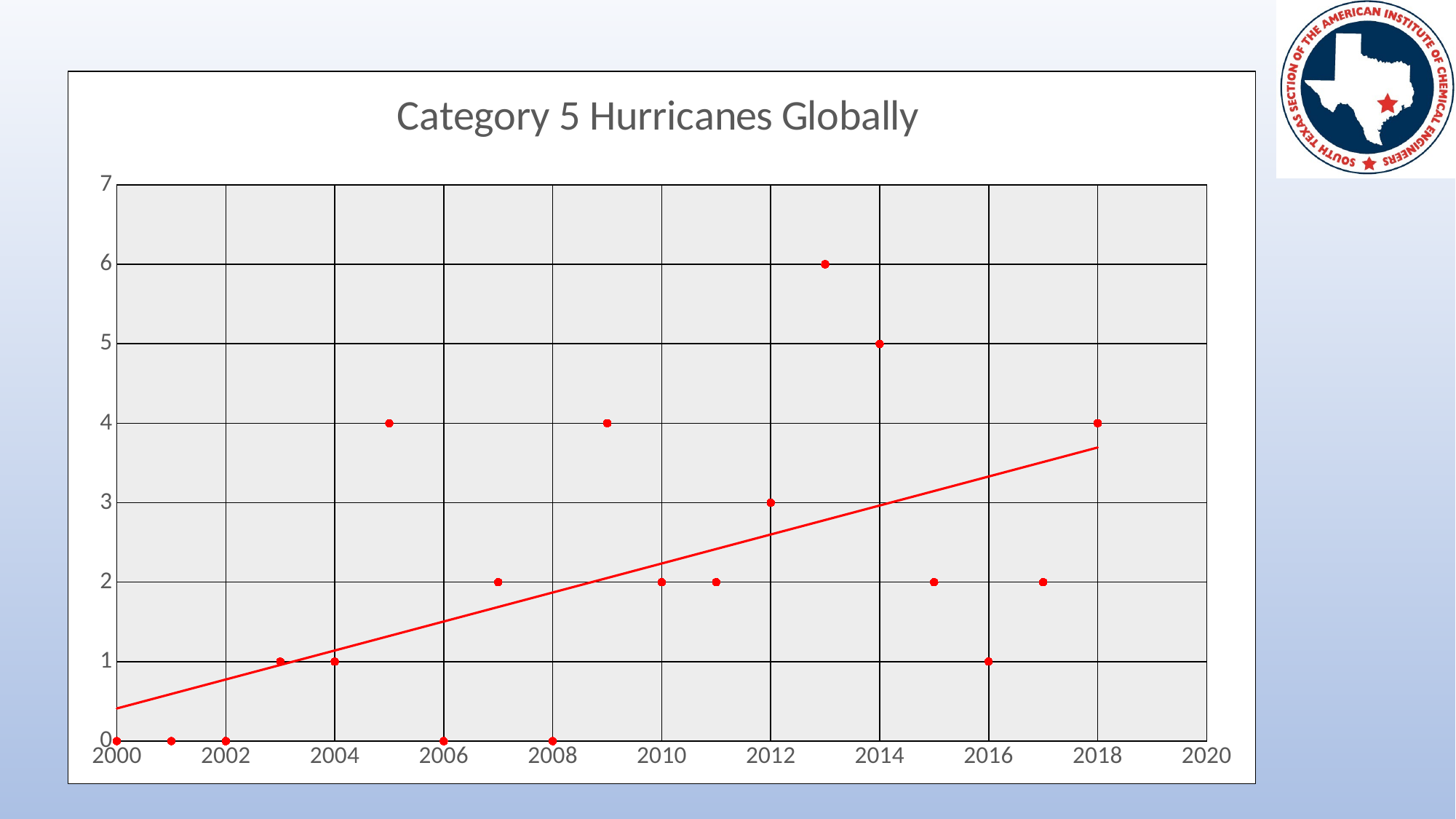
Which year has the highest plotted value? 2013 What is the value plotted for 2013? 6 What is the title of the chart? Category 5 Hurricanes Globally Which year has the larger value, 2005 or 2012? 2005 What type of chart is shown on the slide? scatter chart What is the value plotted for 2005? 4 Does the trend line rise or fall from 2000 to 2018? rise What is the lowest value plotted on the chart? 0 What is the difference between the values for 2013 and 2014? 1 What is the value plotted for 2014? 5 What is the value plotted for 2012? 3 What is the value plotted for 2016? 1